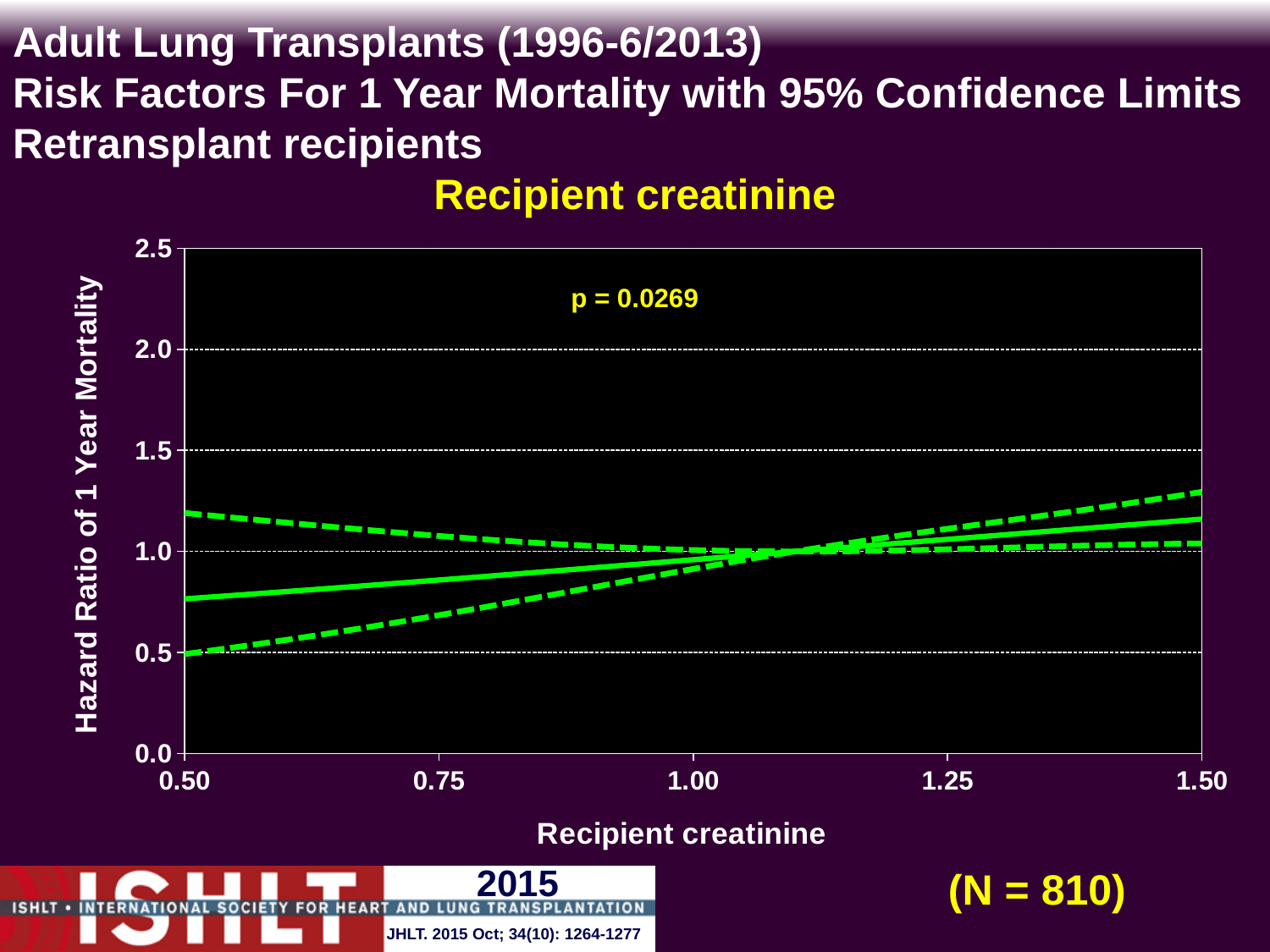
Is the upper confidence limit (upper dashed line) at a recipient creatinine of 1.50 greater or less than 1.5? less What is the p-value printed on the chart? p = 0.0269 Is the hazard ratio (solid line) at a recipient creatinine of 1.50 greater or less than 1.0? greater What kind of chart is shown on the slide? line chart What is the label of the y axis? Hazard Ratio of 1 Year Mortality How many lines are plotted on the chart? 3 Does the solid hazard ratio line rise or fall as recipient creatinine increases from 0.50 to 1.50? rise Is the hazard ratio (solid line) higher at a recipient creatinine of 1.50 or at 0.50? 1.50 What is the highest value shown on the y axis? 2.5 Is the hazard ratio (solid line) at a recipient creatinine of 0.50 greater or less than 1.0? less